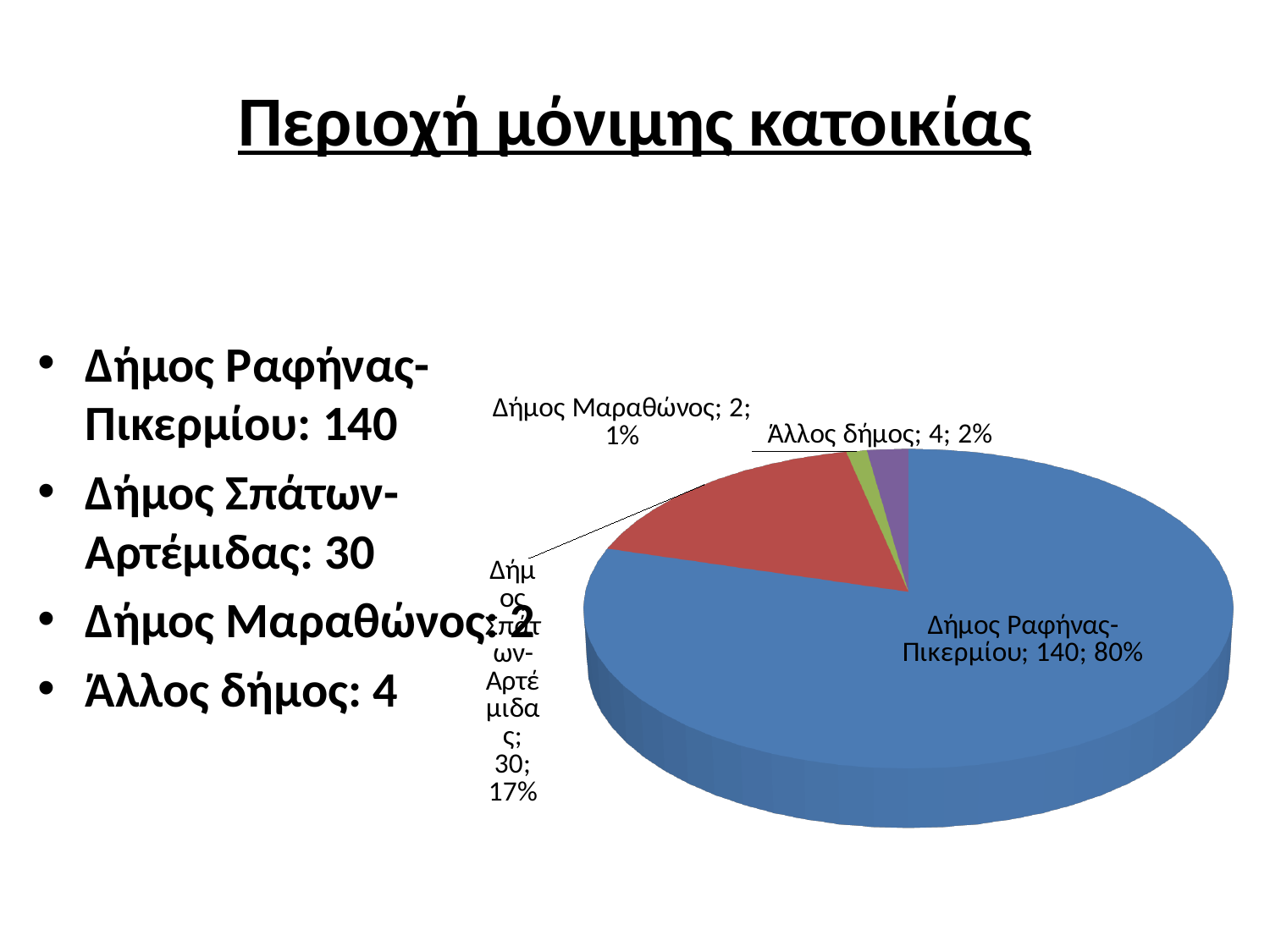
What is the difference between the values for Δήμος Ραφήνας-Πικερμίου and Δήμος Σπάτων-Αρτέμιδας? 110 What is the value for Δήμος Μαραθώνος in the pie chart? 2 What is the value for Δήμος Ραφήνας-Πικερμίου in the pie chart? 140 How many slices does the pie chart have? 4 What is the value for Άλλος δήμος in the pie chart? 4 What share of the pie does Δήμος Ραφήνας-Πικερμίου represent? 80% What share of the pie does Δήμος Σπάτων-Αρτέμιδας represent? 17% What kind of chart is shown on the slide? pie chart Which category has the smallest slice in the pie chart? Δήμος Μαραθώνος What is the value for Δήμος Σπάτων-Αρτέμιδας in the pie chart? 30 Which category has the largest slice in the pie chart? Δήμος Ραφήνας-Πικερμίου Which is larger, the value for Άλλος δήμος or the value for Δήμος Μαραθώνος? Άλλος δήμος